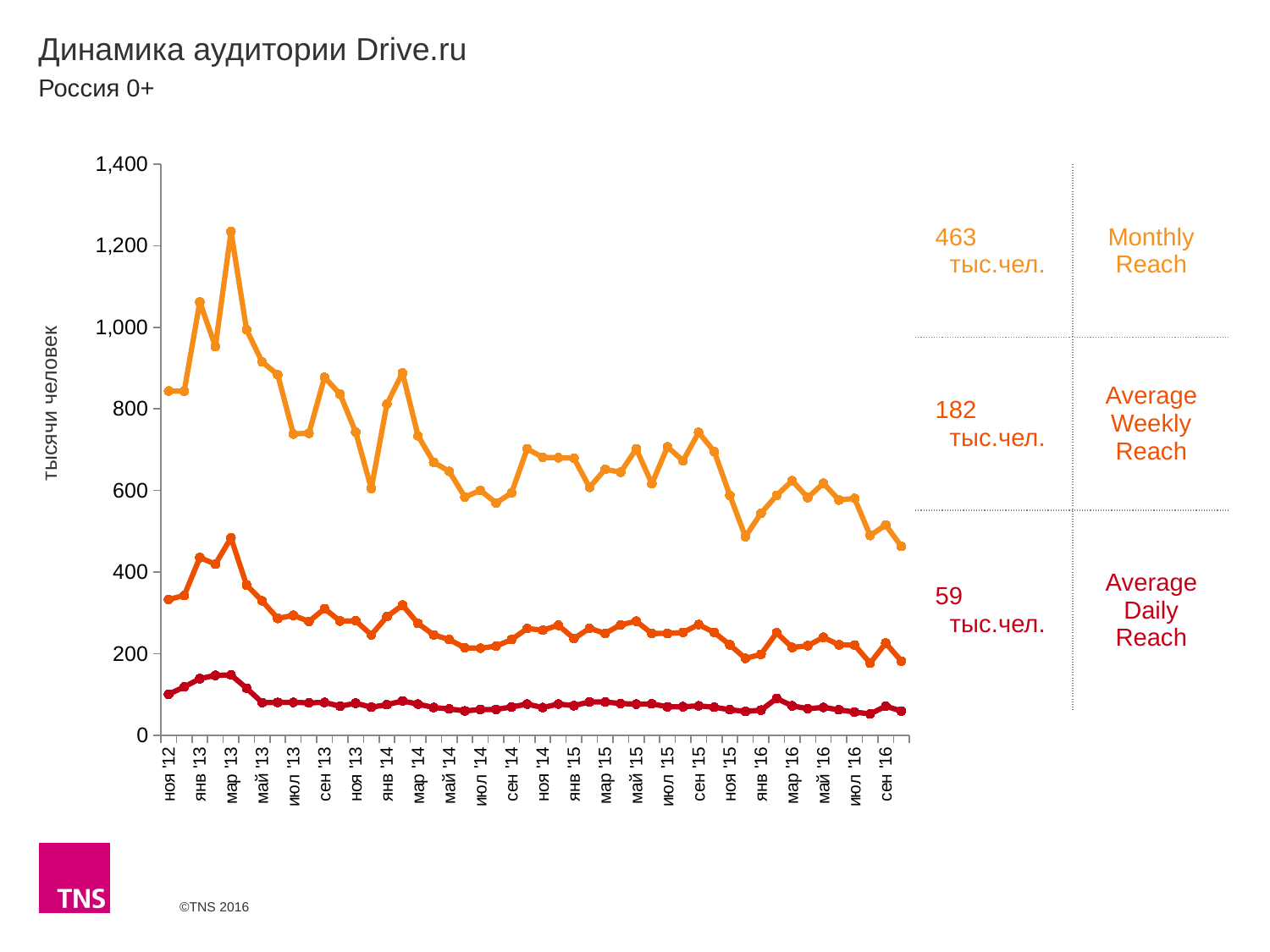
What kind of chart is shown on the slide? line chart What is the latest Monthly Reach value shown on the slide? 463 тыс.чел. What is the latest Average Daily Reach value shown on the slide? 59 тыс.чел. What is the label on the vertical axis of the chart? тысячи человек Is the Monthly Reach value for мар '13 greater or less than 1,000? greater Is the Average Daily Reach value for мар '13 greater or less than 200? less Does Monthly Reach overall rise or fall from ноя '12 to сен '16? fall Which series has the highest values throughout the chart? Monthly Reach How many series are plotted on the chart? 3 What is the latest Average Weekly Reach value shown on the slide? 182 тыс.чел. In which month does Monthly Reach reach its peak? мар '13 What is the difference between the latest Monthly Reach and the latest Average Weekly Reach values? 281 тыс.чел.